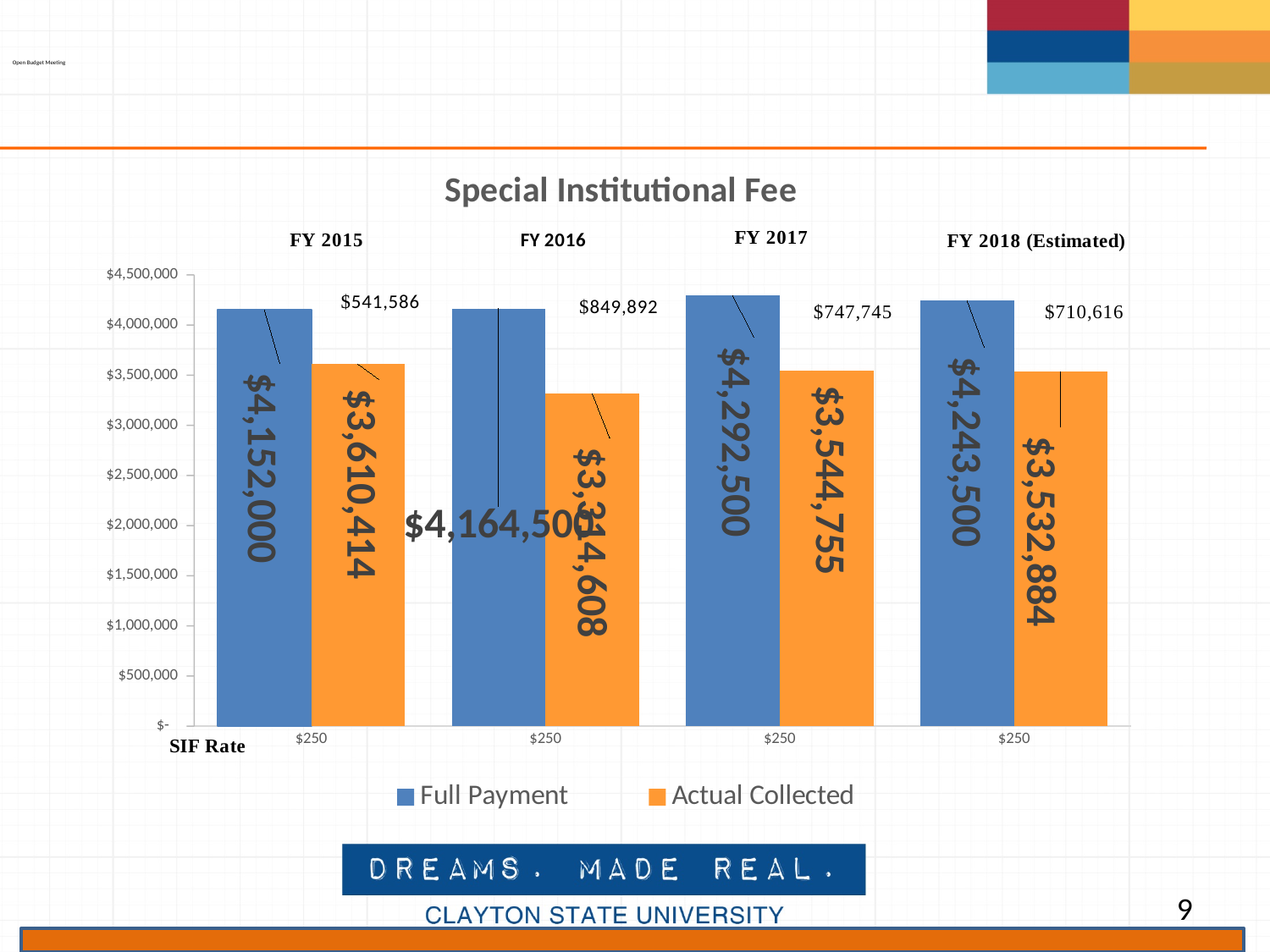
How many series does the legend list? 2 Which fiscal year has the highest Full Payment value? FY 2017 Is the Actual Collected value for FY 2016 greater or less than $3,500,000? less What is the difference between Full Payment and Actual Collected in FY 2015? $541,586 How many fiscal years are shown on the chart? 4 What type of chart is shown on the slide? Bar chart What is the Full Payment value for FY 2018 (Estimated)? $4,243,500 Which fiscal year has the lowest Actual Collected value? FY 2016 What is the title of the chart? Special Institutional Fee What is the Full Payment value for FY 2015? $4,152,000 What is the Actual Collected value for FY 2017? $3,544,755 Which is larger in FY 2018 (Estimated): Full Payment or Actual Collected? Full Payment